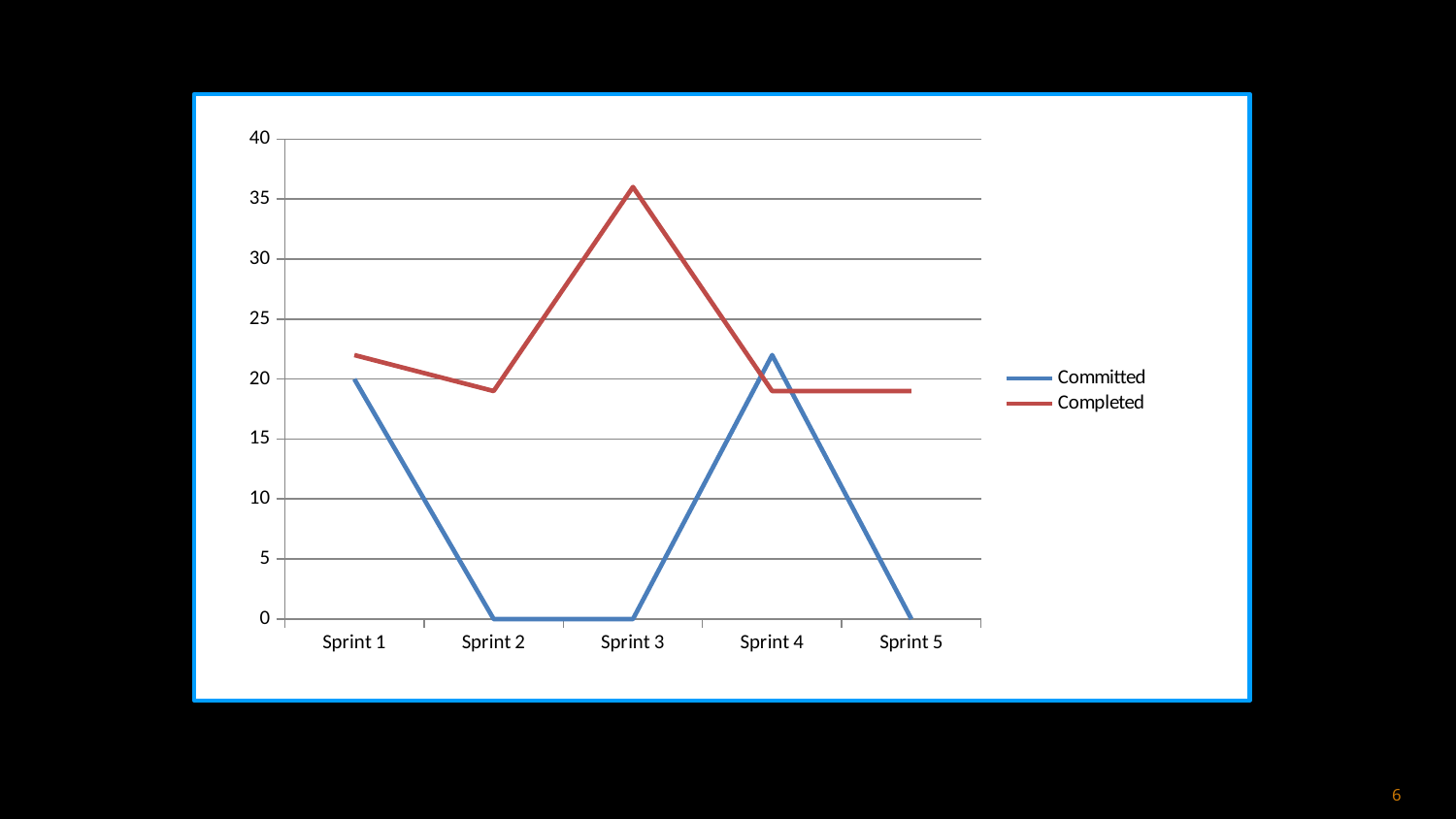
What is the Committed value for Sprint 1? 20 Is the Completed value for Sprint 2 greater or less than 20? less In which sprint is the Completed value highest? Sprint 3 Which is larger in Sprint 3, the Committed value or the Completed value? Completed Is the Completed value for Sprint 3 greater or less than 35? greater Which series is drawn in red? Completed How many series does the legend list? 2 What kind of chart is shown on the slide? line chart What is the Committed value for Sprint 5? 0 Does the Completed line rise or fall from Sprint 2 to Sprint 3? rise How many sprints are shown on the x axis? 5 What is the Committed value for Sprint 2? 0